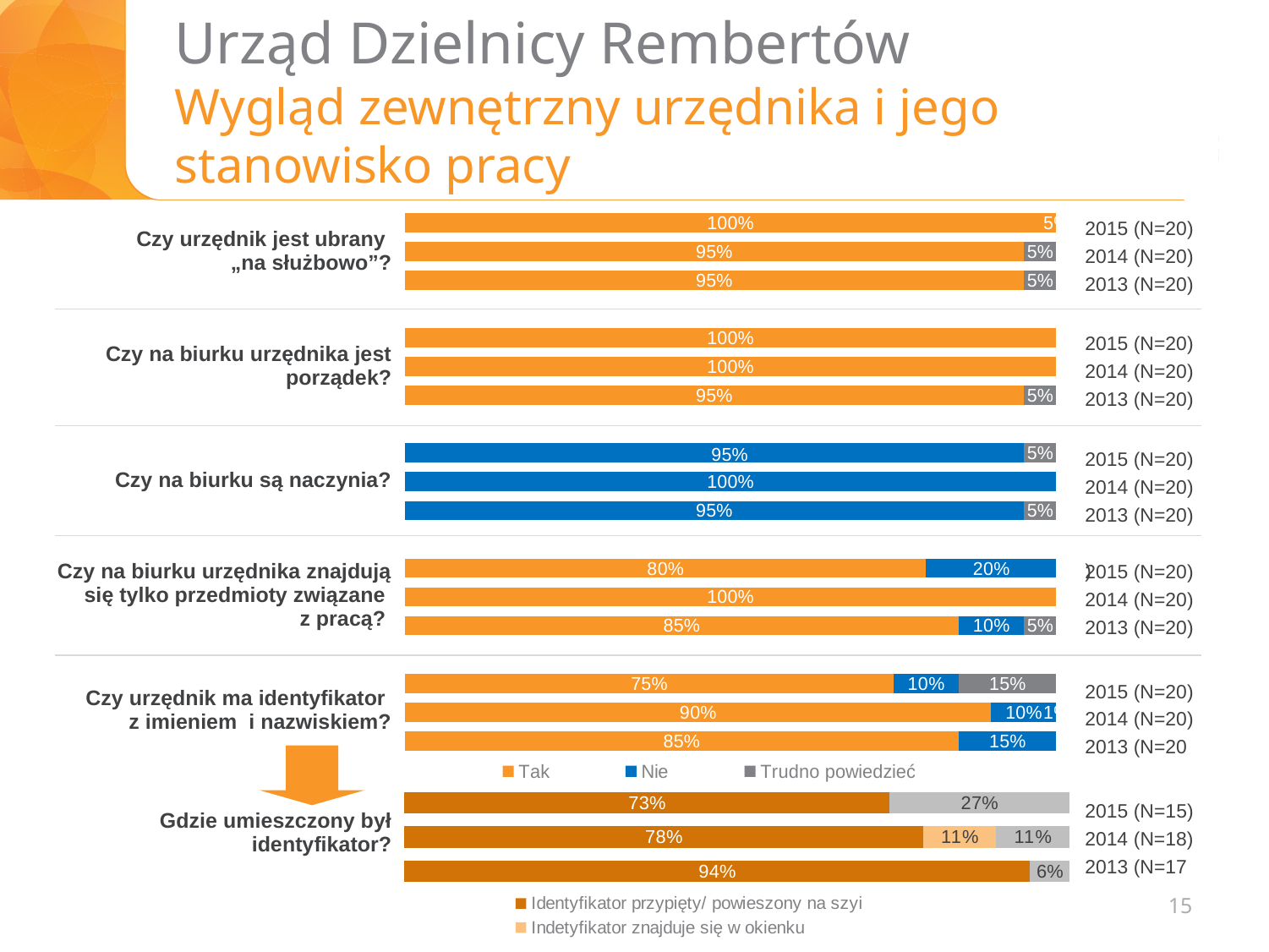
What kind of chart is used for "Czy na biurku są naczynia?"? Stacked bar chart In the chart for "Gdzie umieszczony był identyfikator?", is the 2013 (N=17) value for "Identyfikator przypięty/ powieszony na szyi" larger or smaller than the 2014 (N=18) value? larger In the chart for "Czy na biurku urzędnika znajdują się tylko przedmioty związane z pracą?", which year has the highest "Tak" value? 2014 (N=20) In the chart for "Czy urzędnik ma identyfikator z imieniem i nazwiskiem?", what is the difference between the "Tak" values for 2014 (N=20) and 2015 (N=20)? 15% In the chart for "Gdzie umieszczony był identyfikator?", what is the value for "Indetyfikator znajduje się w okienku" in 2014 (N=18)? 11% In the chart for "Czy na biurku urzędnika jest porządek?", what is the "Tak" value for 2013 (N=20)? 95% How many series does the legend list for the chart "Czy urzędnik ma identyfikator z imieniem i nazwiskiem?"? 3 In the chart for "Czy urzędnik ma identyfikator z imieniem i nazwiskiem?", what is the "Trudno powiedzieć" value for 2015 (N=20)? 15% In the chart for "Gdzie umieszczony był identyfikator?", which year has the lowest value for "Identyfikator przypięty/ powieszony na szyi"? 2015 (N=15) In the chart for "Czy urzędnik ma identyfikator z imieniem i nazwiskiem?", what is the "Tak" value for 2015 (N=20)? 75% In the chart for "Gdzie umieszczony był identyfikator?", what is the value for "Identyfikator przypięty/ powieszony na szyi" in 2013 (N=17)? 94% In the chart for "Czy na biurku urzędnika znajdują się tylko przedmioty związane z pracą?", what is the "Nie" value for 2015 (N=20)? 20%